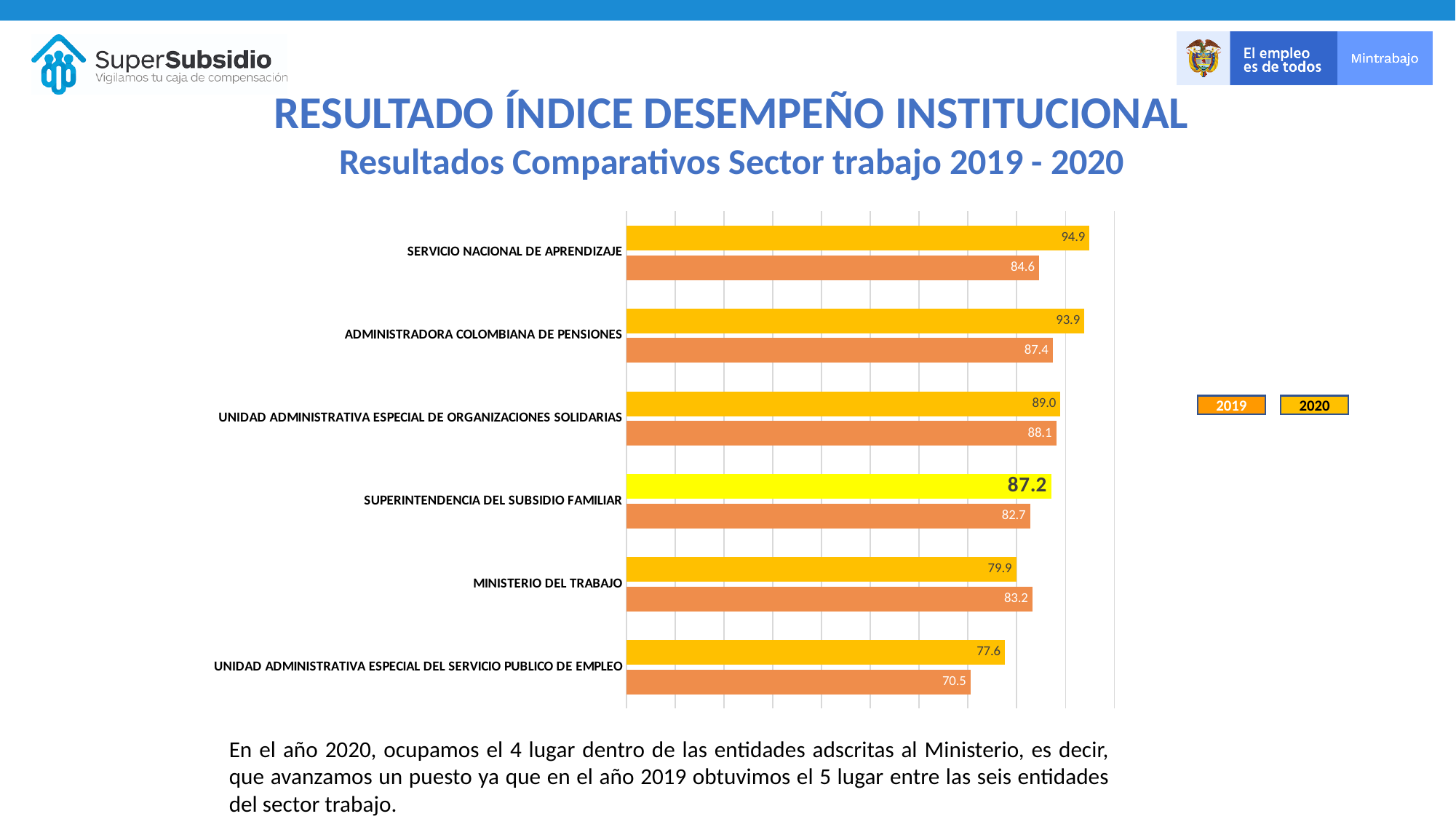
What is the difference between the 2020 and 2019 values for SERVICIO NACIONAL DE APRENDIZAJE? 10.3 Which entity's 2020 bar is highlighted in bright yellow? SUPERINTENDENCIA DEL SUBSIDIO FAMILIAR How many series does the legend list? 2 Which entity had the lowest 2019 value? UNIDAD ADMINISTRATIVA ESPECIAL DEL SERVICIO PUBLICO DE EMPLEO How many entities are shown in the chart? 6 What was the 2019 value for SUPERINTENDENCIA DEL SUBSIDIO FAMILIAR? 82.7 What is the difference between the 2020 and 2019 values for SUPERINTENDENCIA DEL SUBSIDIO FAMILIAR? 4.5 What was the 2020 value for SERVICIO NACIONAL DE APRENDIZAJE? 94.9 What kind of chart is shown on the slide? Bar chart Which entity had the highest 2020 value? SERVICIO NACIONAL DE APRENDIZAJE For MINISTERIO DEL TRABAJO, which year had the larger value, 2019 or 2020? 2019 What was the 2019 value for MINISTERIO DEL TRABAJO? 83.2